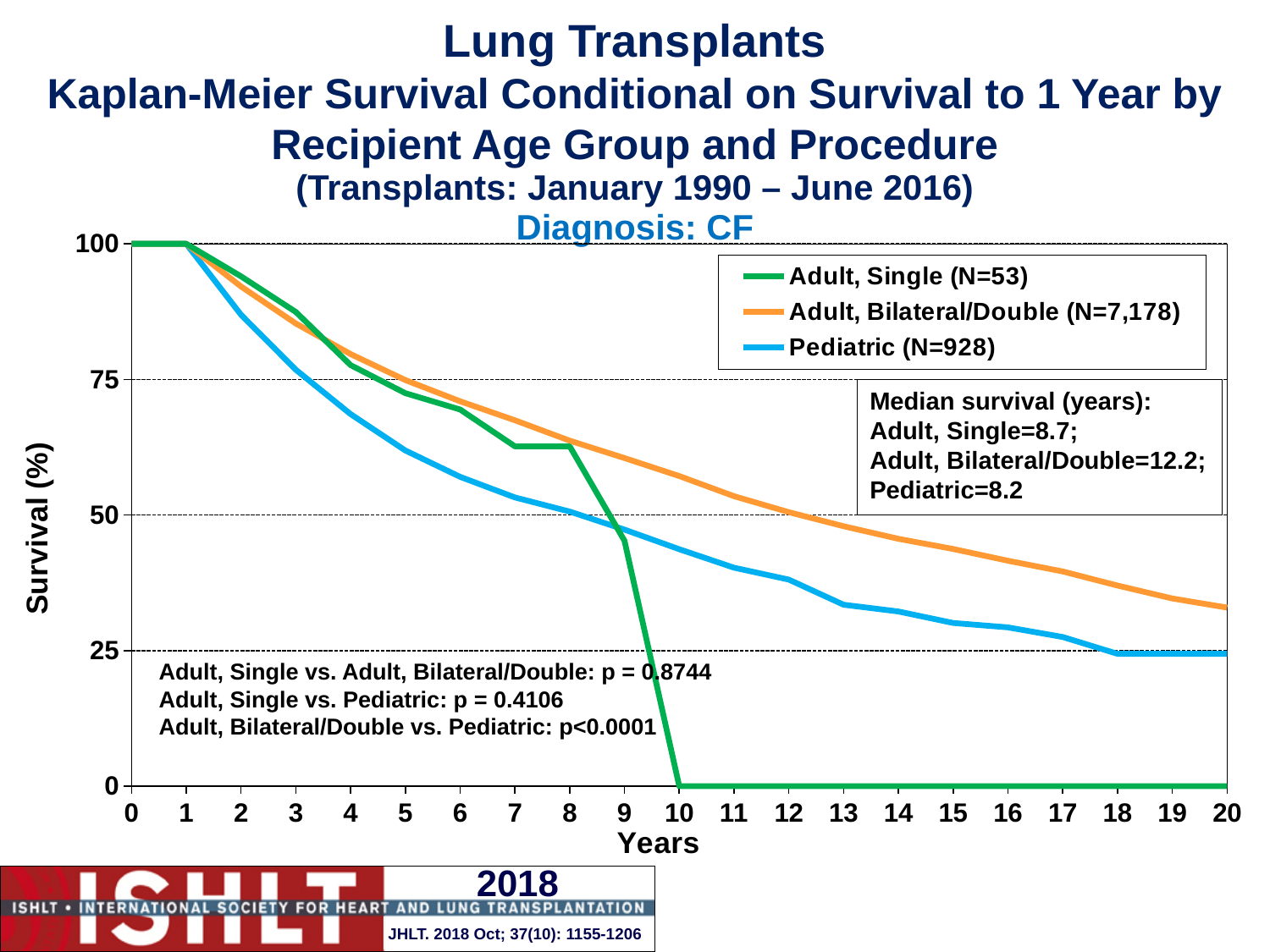
Is the survival value for the Pediatric curve at 5 years greater or less than 75? less How many series does the legend list? 3 What is the median survival in years for the Adult, Bilateral/Double group? 12.2 What is the p-value for Adult, Bilateral/Double vs. Pediatric? p<0.0001 What is the median survival in years for the Adult, Single group? 8.7 What is the difference in median survival (years) between Adult, Bilateral/Double and Pediatric? 4.0 What is the N for the Pediatric group shown in the legend? 928 Which group has the highest median survival? Adult, Bilateral/Double Is the survival value for the Adult, Bilateral/Double curve at 20 years greater or less than 50? less What type of chart is shown on the slide? line chart What is the median survival in years for the Pediatric group? 8.2 Which group has the lowest median survival? Pediatric